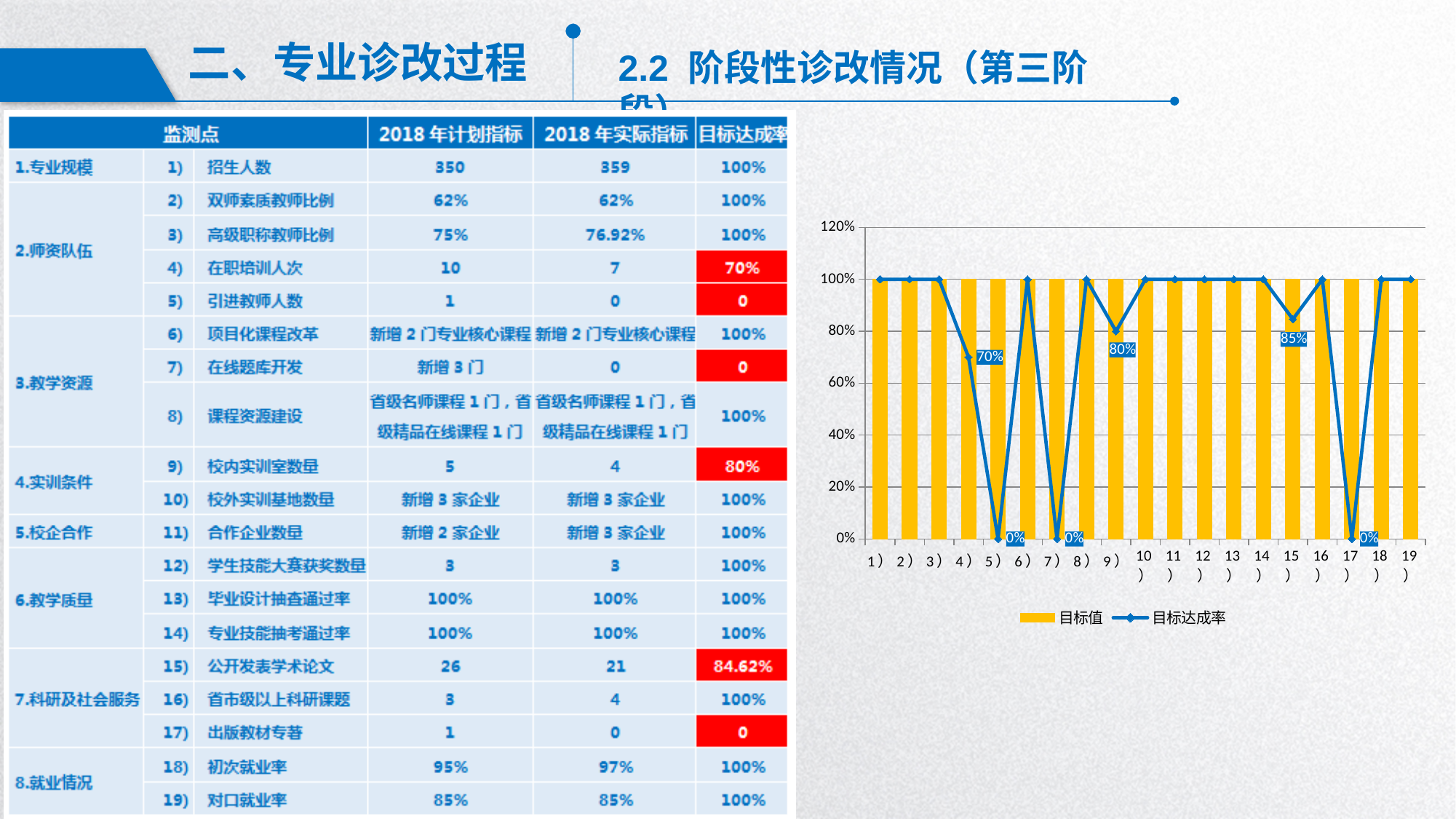
Which colour are the 目标值 bars in the chart? Yellow What is the 目标达成率 value labelled at category 17) in the chart? 0% What is the 目标达成率 value labelled at category 4) in the chart? 70% How many series does the chart legend list? 2 What kind of chart is shown on the right of the slide? A combined bar and line chart What are the two series named in the chart legend? 目标值 and 目标达成率 Is the 目标达成率 value at category 5) in the chart greater or less than 20%? less Which is larger in the chart, the 目标达成率 at category 4) or at category 9)? Category 9) How many categories are plotted along the x axis of the chart? 19 What is the 目标达成率 value labelled at category 15) in the chart? 85% What is the difference between the 目标达成率 at category 15) and at category 4) in the chart? 15% What is the 目标达成率 value labelled at category 9) in the chart? 80%